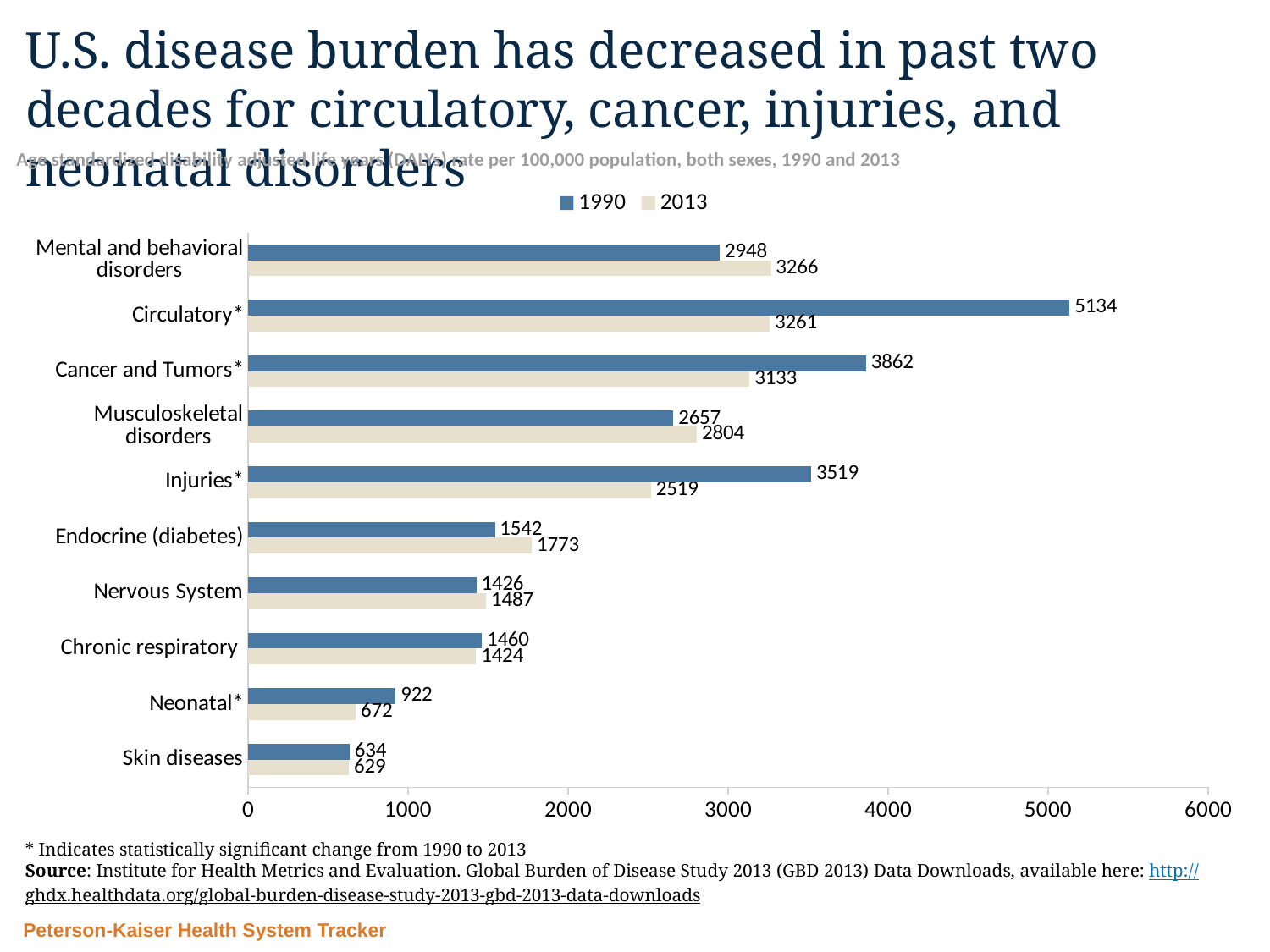
What is the 2013 value for Mental and behavioral disorders? 3266 What kind of chart is shown on the slide? bar chart What is the 1990 value for Circulatory*? 5134 What is the 2013 value for Injuries*? 2519 Which category has the highest 1990 value? Circulatory* How many categories are shown on the chart? 10 How many series does the legend list? 2 What is the difference between the 1990 and 2013 values for Neonatal*? 250 What is the difference between the 1990 and 2013 values for Circulatory*? 1873 Which category has the lowest 2013 value? Skin diseases Which is larger for Endocrine (diabetes): the 1990 value or the 2013 value? 2013 Is the 1990 value for Cancer and Tumors* greater or less than 3000? greater